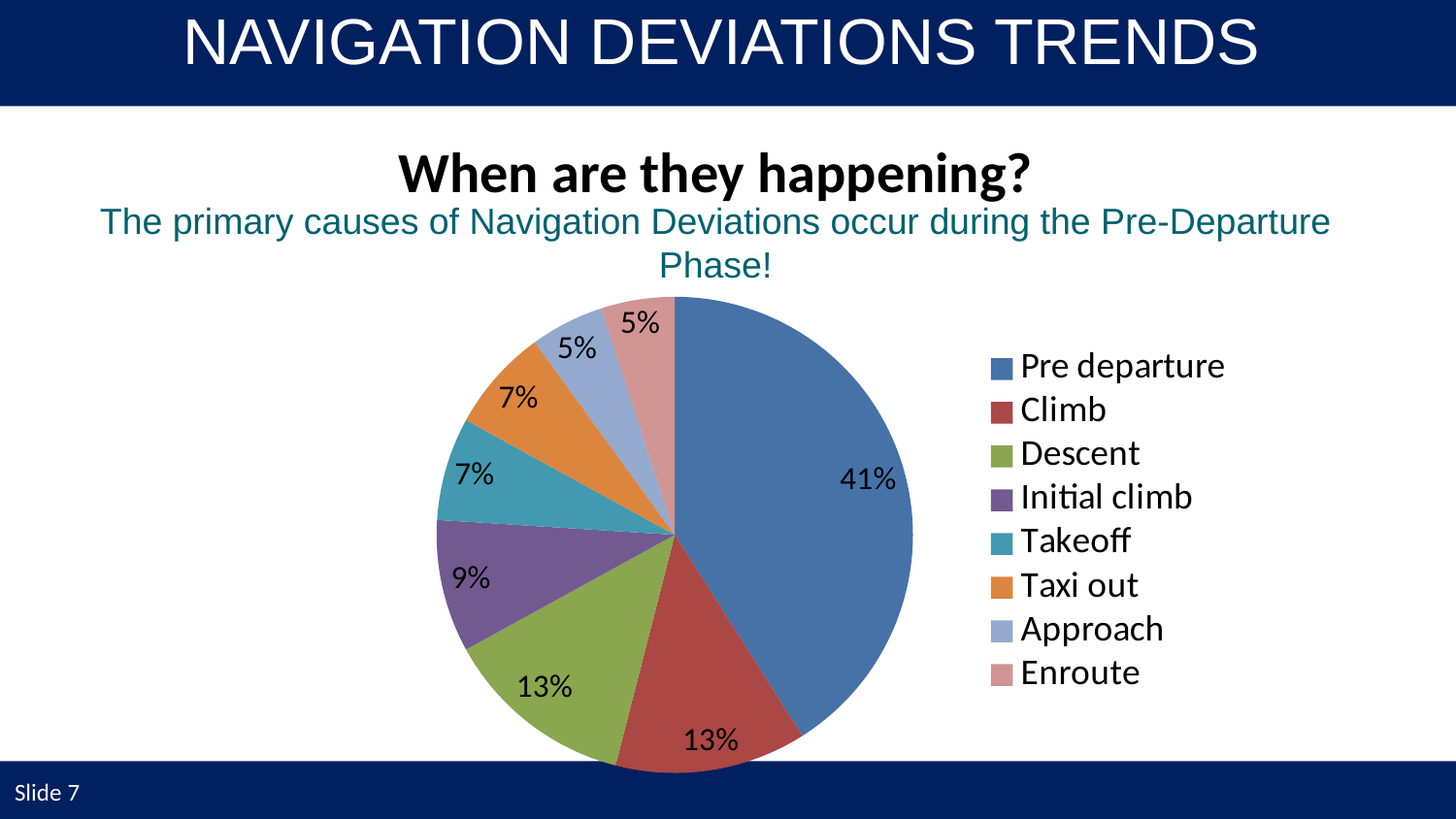
Which legend entry is shown in orange? Taxi out How many slices does the pie chart have? 8 What is the combined share of the Climb and Descent slices? 26% What is the difference in percentage points between the Pre departure slice and the Climb slice? 28 What percentage is shown for the Takeoff slice? 7% How many entries does the legend list? 8 What share of navigation deviations occurs during the Pre departure phase? 41% Which phase has the largest slice of the pie? Pre departure What percentage is shown for the Approach slice? 5% What percentage is shown for the Initial climb slice? 9% What type of chart is shown on the slide? pie chart Which slice is larger, Initial climb or Taxi out? Initial climb